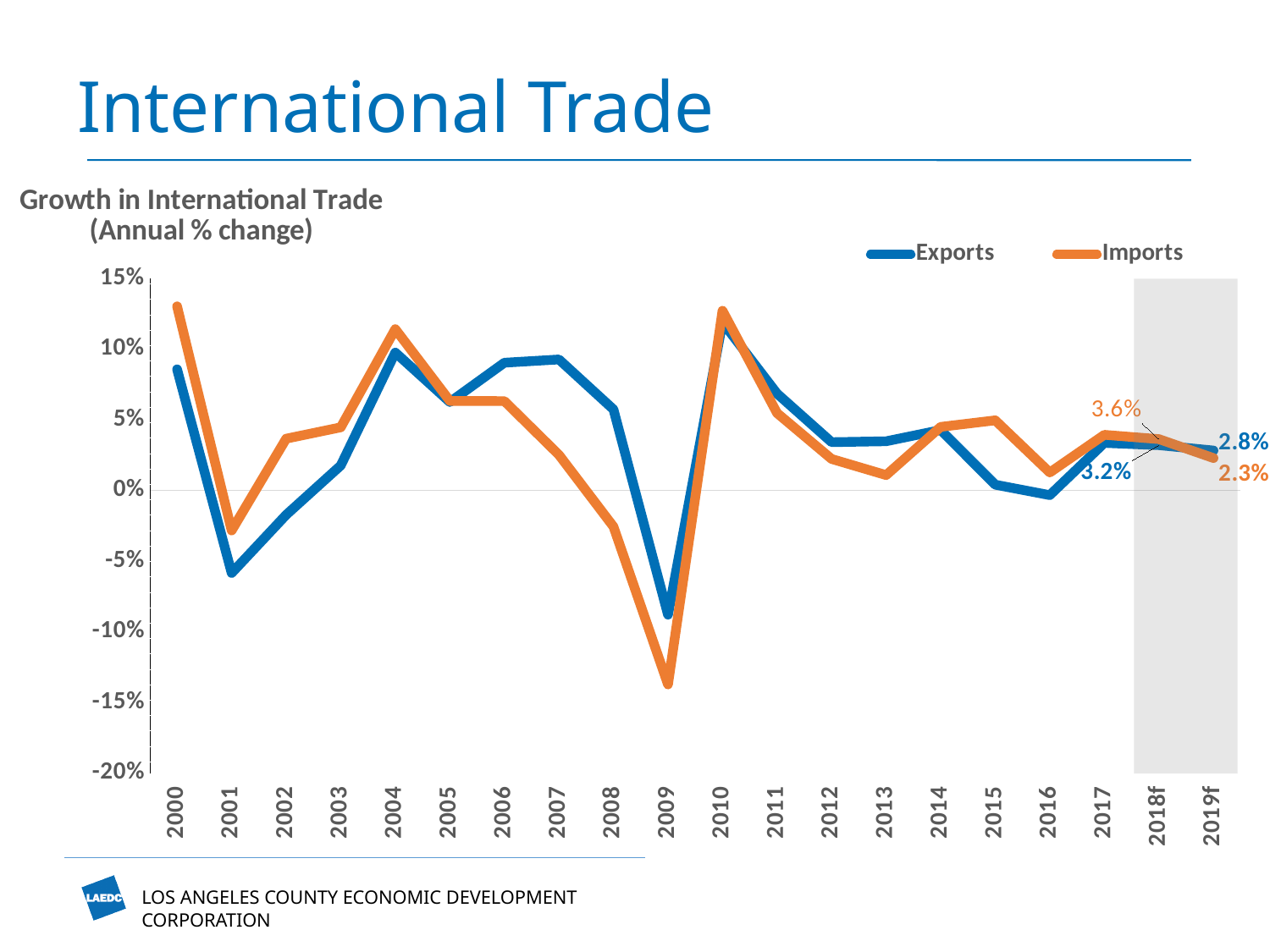
What is the forecast value for Exports in 2019f? 2.8% Is the value for Imports in 2009 greater or less than -10%? less What is the forecast value for Exports in 2018f? 3.2% Is the value for Exports in 2010 greater or less than 10%? greater In which year does the Imports line reach its lowest point? 2009 Does the Imports line rise or fall from 2006 to 2009? Fall In 2018f, which series has the higher forecast value, Exports or Imports? Imports What is the forecast value for Imports in 2019f? 2.3% What kind of chart is shown on the slide? Line chart What is the forecast value for Imports in 2018f? 3.6% In 2019f, how many percentage points higher is the Exports forecast than the Imports forecast? 0.5 How many series does the legend list? 2